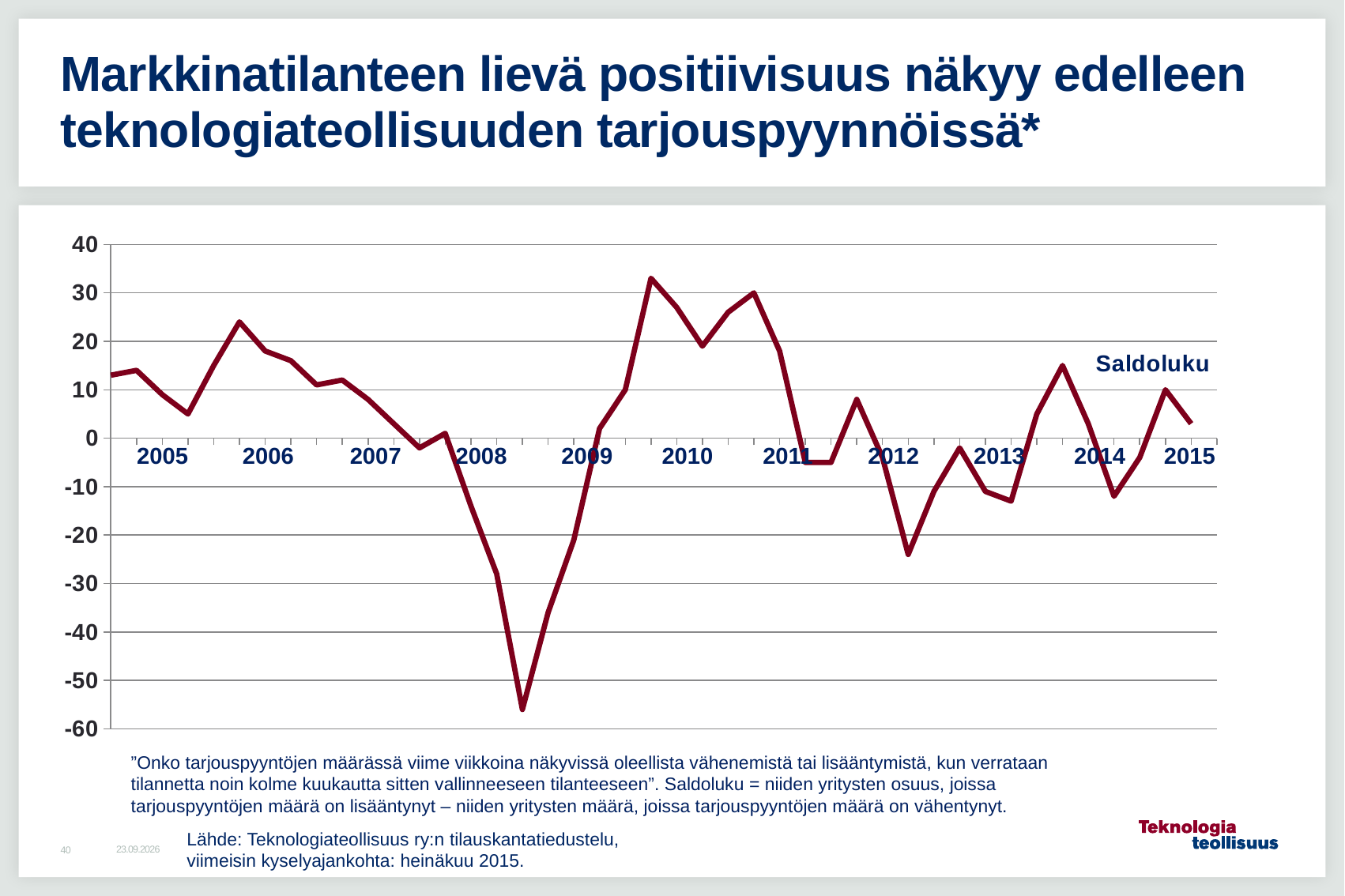
What are the lowest and highest values shown on the y axis? -60 and 40 Is the value at the start of 2005 greater or less than 10? greater Which is higher, the value at the start of 2005 or the last value in 2015? the value at the start of 2005 In which year does the line reach its highest point? 2010 What is the name of the series plotted on the chart? Saldoluku How many year labels are shown on the x axis? 11 Is the lowest point of the line greater or less than -50? less Is the lowest value in 2012 greater or less than -20? less What kind of chart is shown on the slide? line chart